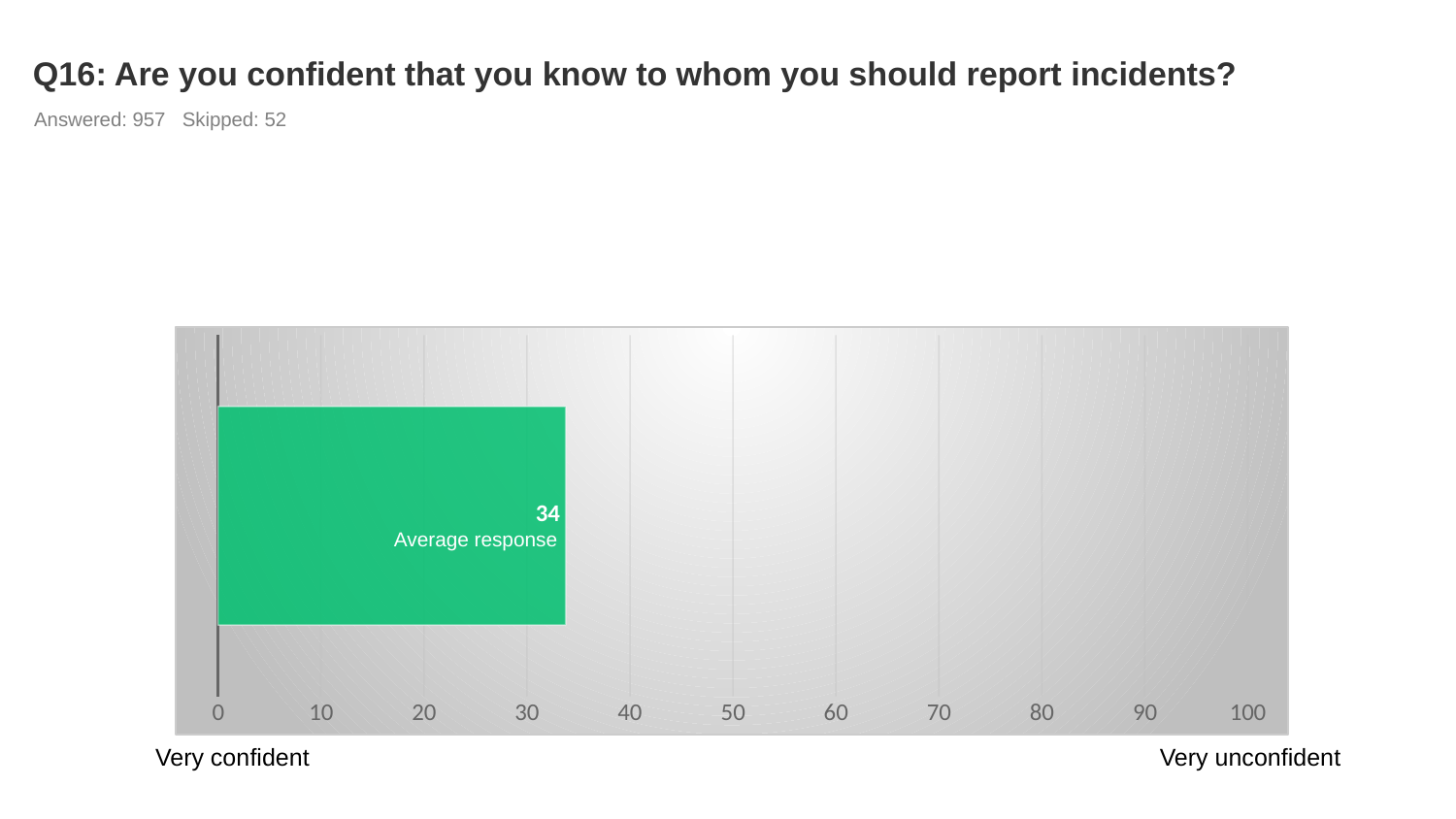
What label appears at the left end of the scale below the chart? Very confident What is the maximum value shown on the x axis? 100 Is the average response value greater or less than 30? greater What is the average response value shown on the chart? 34 How many respondents skipped the question according to the slide? 52 How many bars are plotted on the chart? 1 Is the average response value greater or less than 40? less How many respondents answered the question according to the slide? 957 What kind of chart is shown on the slide? bar chart